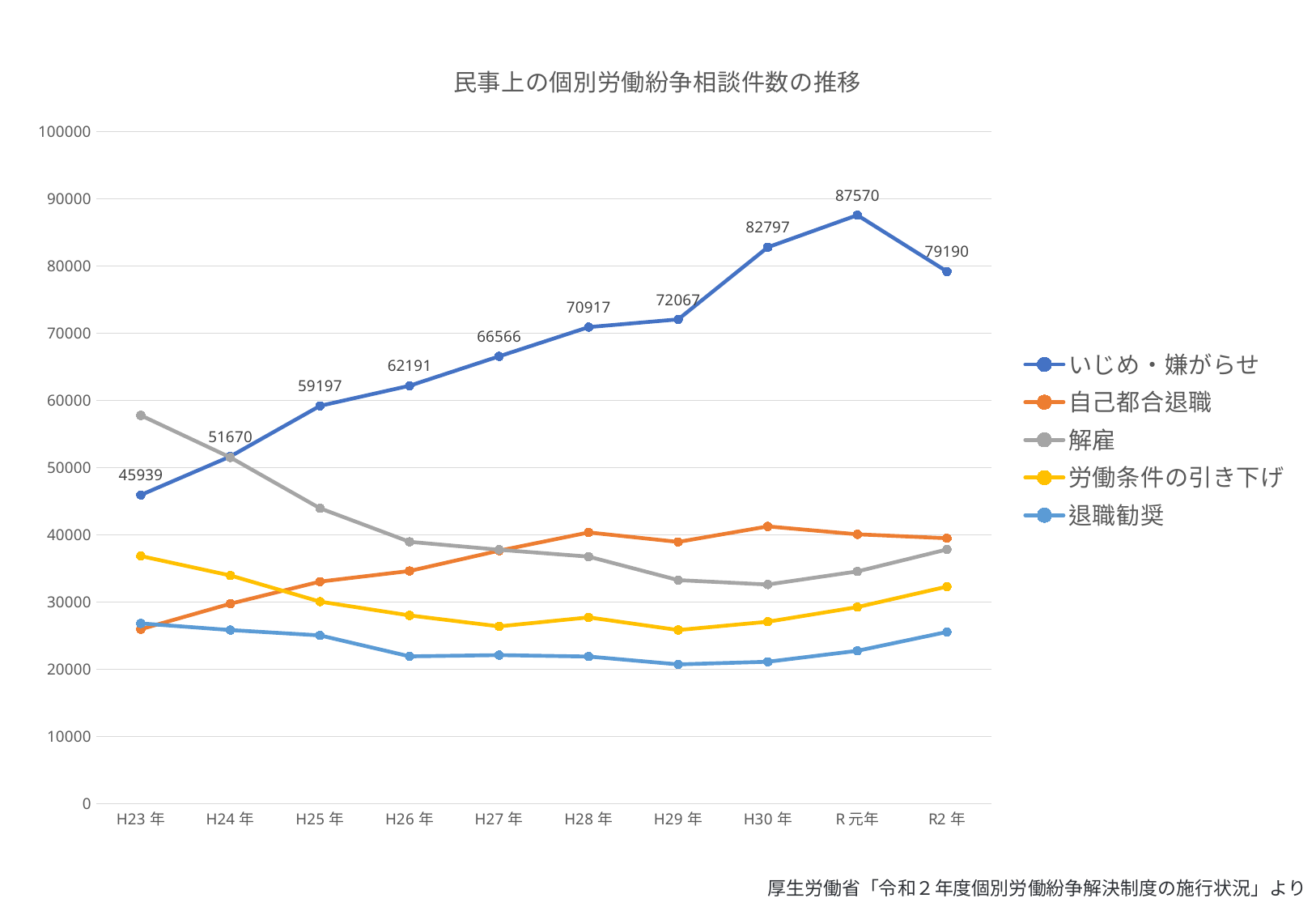
What is the value for いじめ・嫌がらせ in R元年? 87570 What is the difference between the いじめ・嫌がらせ values for R元年 and R2年? 8380 What type of chart is shown on the slide? line chart In which year is the value for いじめ・嫌がらせ lowest? H23年 What is the value for いじめ・嫌がらせ in H23年? 45939 Is the value for 解雇 in H23年 greater or less than 50000? greater In which year is the value for いじめ・嫌がらせ highest? R元年 How many years are shown along the x axis? 10 Does the 解雇 series rise or fall from H23年 to H30年? fall What is the title of the chart? 民事上の個別労働紛争相談件数の推移 How many series does the legend list? 5 What is the value for いじめ・嫌がらせ in H28年? 70917